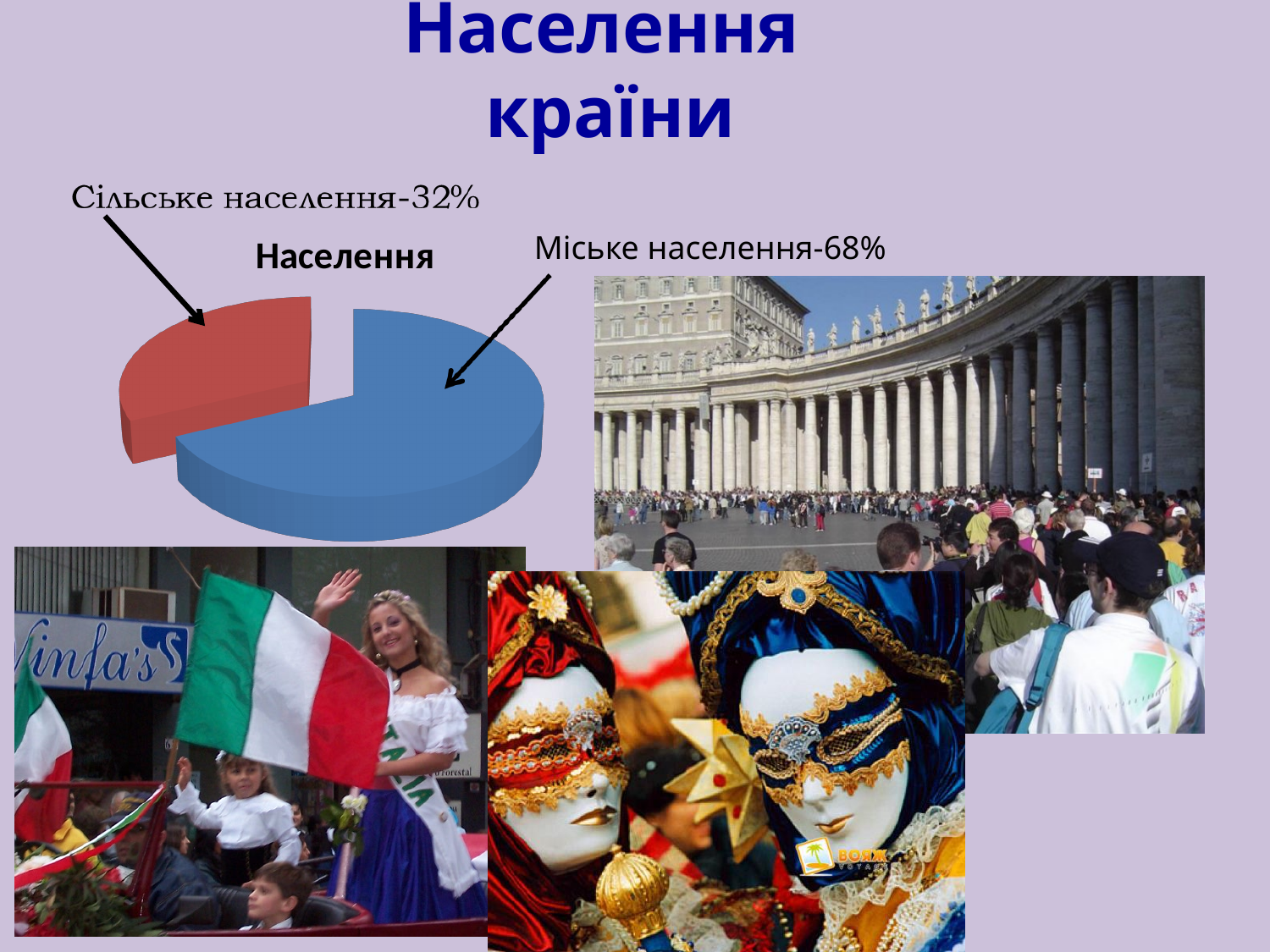
What share of the population is urban (Міське населення)? 68% How many slices does the pie chart have? 2 What share of the population is rural (Сільське населення)? 32% Which slice is the smallest in the pie chart? Сільське населення What is the difference in percentage points between the urban and rural population shares? 36 Is the share for Міське населення greater or less than 50%? greater What is the title of the chart? Населення Which slice is the largest in the pie chart? Міське населення What kind of chart is shown on the slide? pie chart Which is larger, the urban population share or the rural population share? Міське населення What colour is the slice representing the rural population (Сільське населення)? red